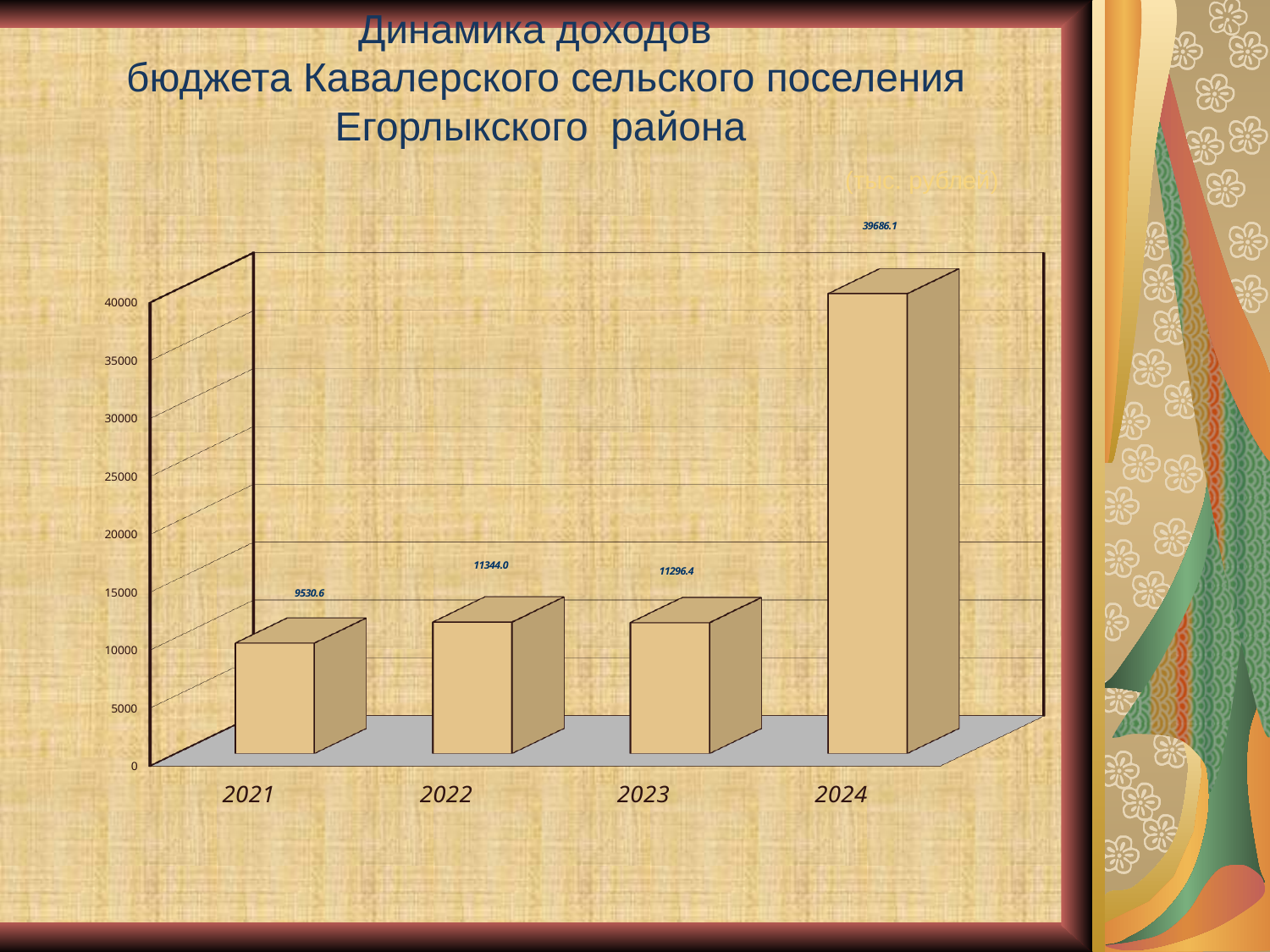
What is the value for 2023? 11296.4 Which year has the highest value? 2024 What is the difference between the values for 2022 and 2021? 1813.4 Which year has the lowest value? 2021 How many years are shown on the chart? 4 What is the difference between the values for 2024 and 2023? 28389.7 What kind of chart is shown on the slide? bar chart What is the value for 2022? 11344.0 What is the value for 2024? 39686.1 What is the value for 2021? 9530.6 Which is larger, the value for 2022 or the value for 2021? 2022 Is the value for 2024 greater or less than 35000? greater